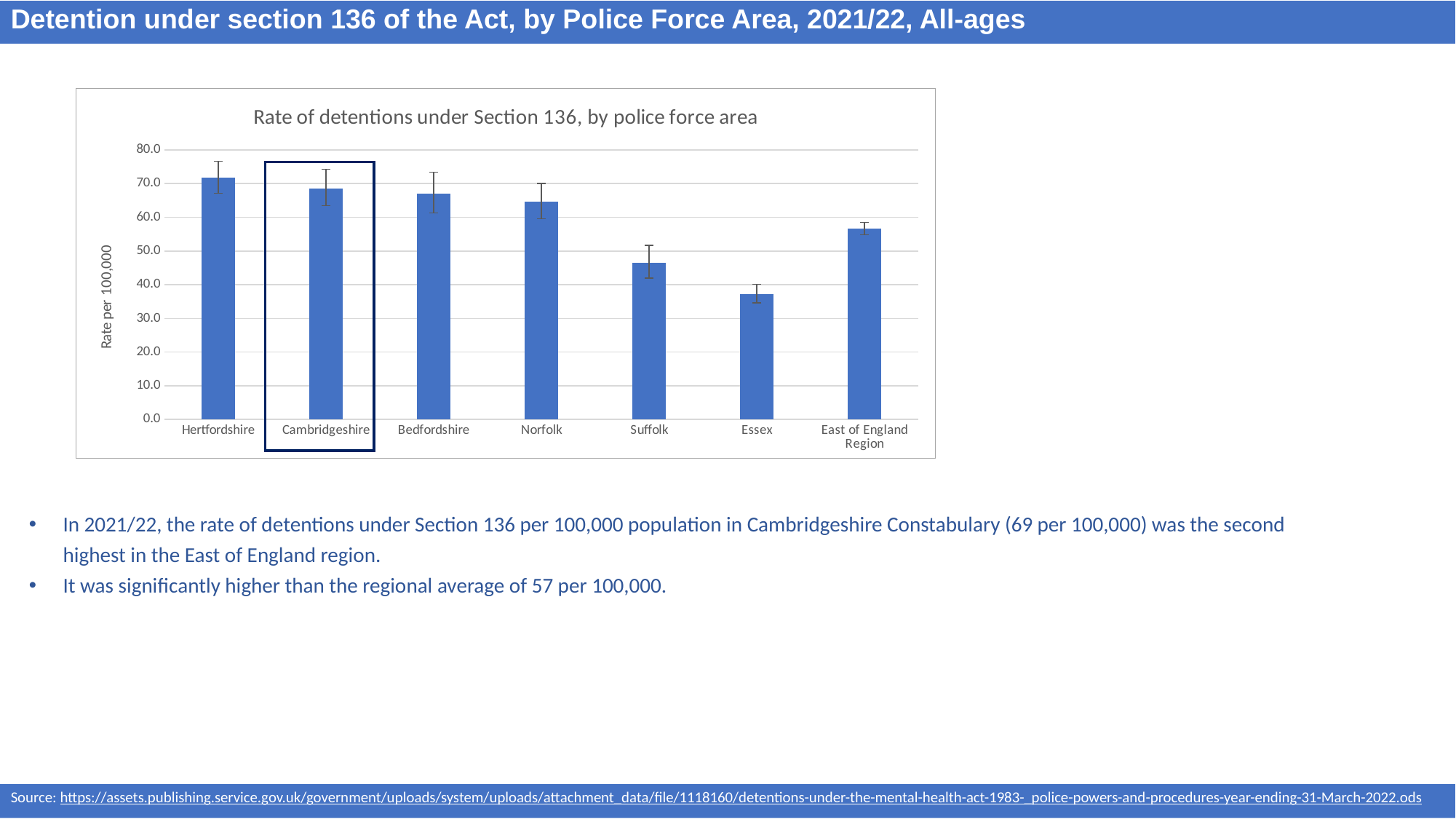
Is the rate for Essex greater or less than 40.0? less What kind of chart is shown on the slide? bar chart Which police force area has the highest rate of detentions under Section 136? Hertfordshire Is the rate for Norfolk greater or less than 60.0? greater What is the label on the vertical axis of the chart? Rate per 100,000 Which has a higher rate of detentions, Suffolk or Norfolk? Norfolk How many police force areas (categories) are plotted on the chart? 7 What is the title of the chart? Rate of detentions under Section 136, by police force area Is the rate for the East of England Region greater or less than 60.0? less Which has a higher rate of detentions, Essex or the East of England Region? East of England Region Which police force area has the lowest rate of detentions under Section 136? Essex